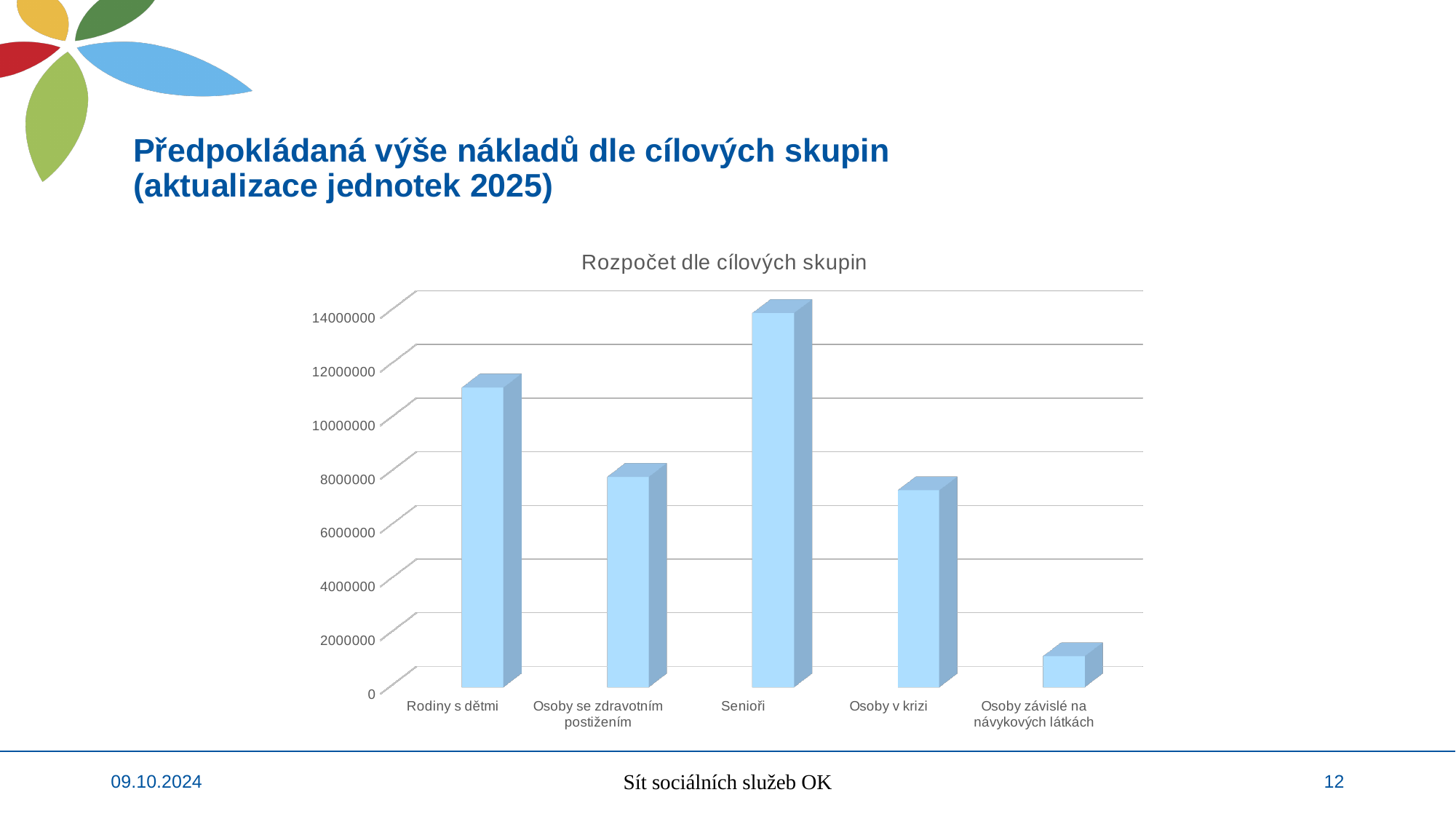
Is the value for Rodiny s dětmi greater or less than 10000000? greater What is the title of the chart? Rozpočet dle cílových skupin Which has a larger value, Rodiny s dětmi or Osoby v krizi? Rodiny s dětmi Is the value for Osoby se zdravotním postižením greater or less than 6000000? greater Is the value for Osoby v krizi greater or less than 8000000? less How many target groups (categories) are shown on the x axis of the chart? 5 Which target group has the lowest budget in the chart? Osoby závislé na návykových látkách Which target group has the highest budget in the chart? Senioři Which has a larger value, Senioři or Osoby se zdravotním postižením? Senioři What type of chart is shown on the slide? Bar chart